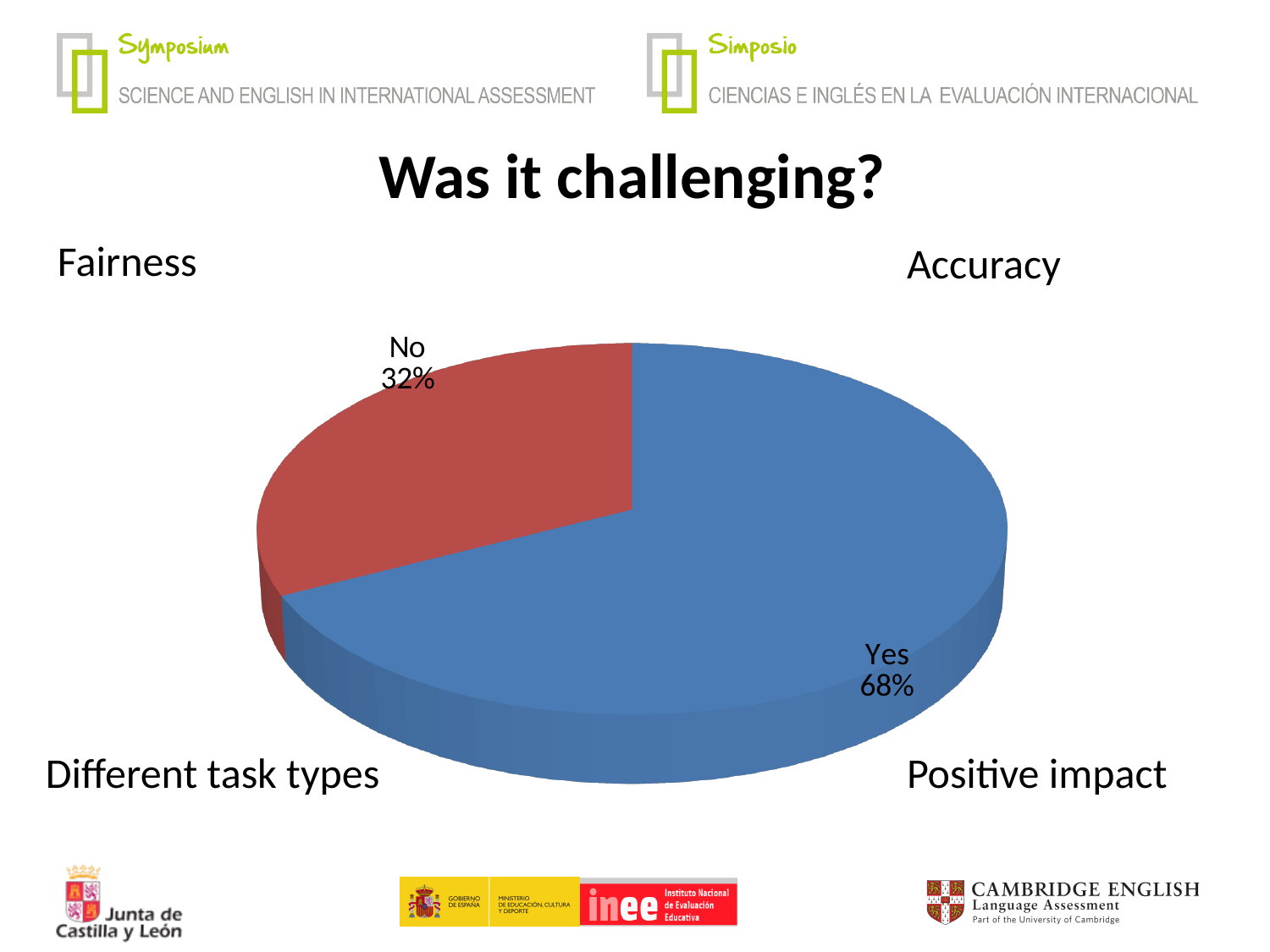
What percentage of the pie is labelled "Yes"? 68% What share of the pie does the "No" slice represent? 32% What colour is the "Yes" slice of the pie chart? blue What kind of chart is shown on the slide? pie chart Which is larger, the "Yes" slice or the "No" slice? Yes How many slices does the pie chart have? 2 What is the title of the slide containing the pie chart? Was it challenging? What is the difference in percentage points between the "Yes" and "No" slices? 36 Which slice of the pie is the largest? Yes Which slice of the pie is the smallest? No What percentage of the pie is labelled "No"? 32%